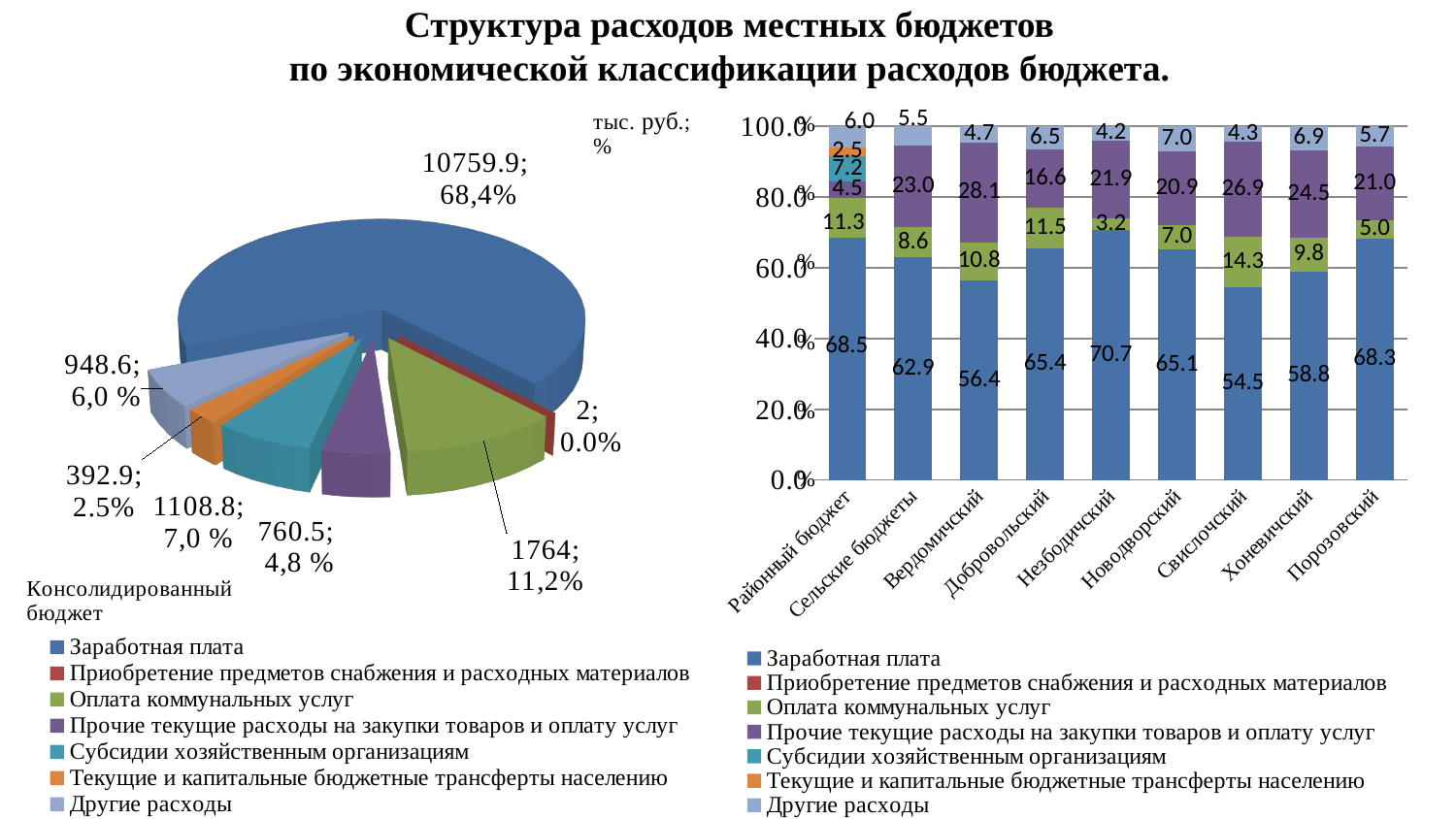
In the pie chart on the left, how many series does the legend list? 7 In the stacked bar chart on the right, what is the difference between the Заработная плата values for Незбодичский and Свислочский? 16.2 What kind of chart is on the right side of the slide? Stacked bar chart In the stacked bar chart on the right, what is the value of Другие расходы for Новодворский? 7.0 In the stacked bar chart on the right, how many categories are shown on the x axis? 9 In the stacked bar chart on the right, which category has the highest value for Прочие текущие расходы на закупки товаров и оплату услуг? Вердомичский In the pie chart on the left, what percentage share is shown for Оплата коммунальных услуг (the green slice)? 11,2% In the stacked bar chart on the right, which category has the lowest value for Заработная плата? Свислочский In the stacked bar chart on the right, which is larger: Оплата коммунальных услуг for Свислочский or for Порозовский? Свислочский In the stacked bar chart on the right, what is the value of Заработная плата for Незбодичский? 70.7 In the pie chart on the left, what value is shown for the largest slice (Заработная плата)? 10759.9; 68,4% In the pie chart on the left, which category has the smallest slice? Приобретение предметов снабжения и расходных материалов